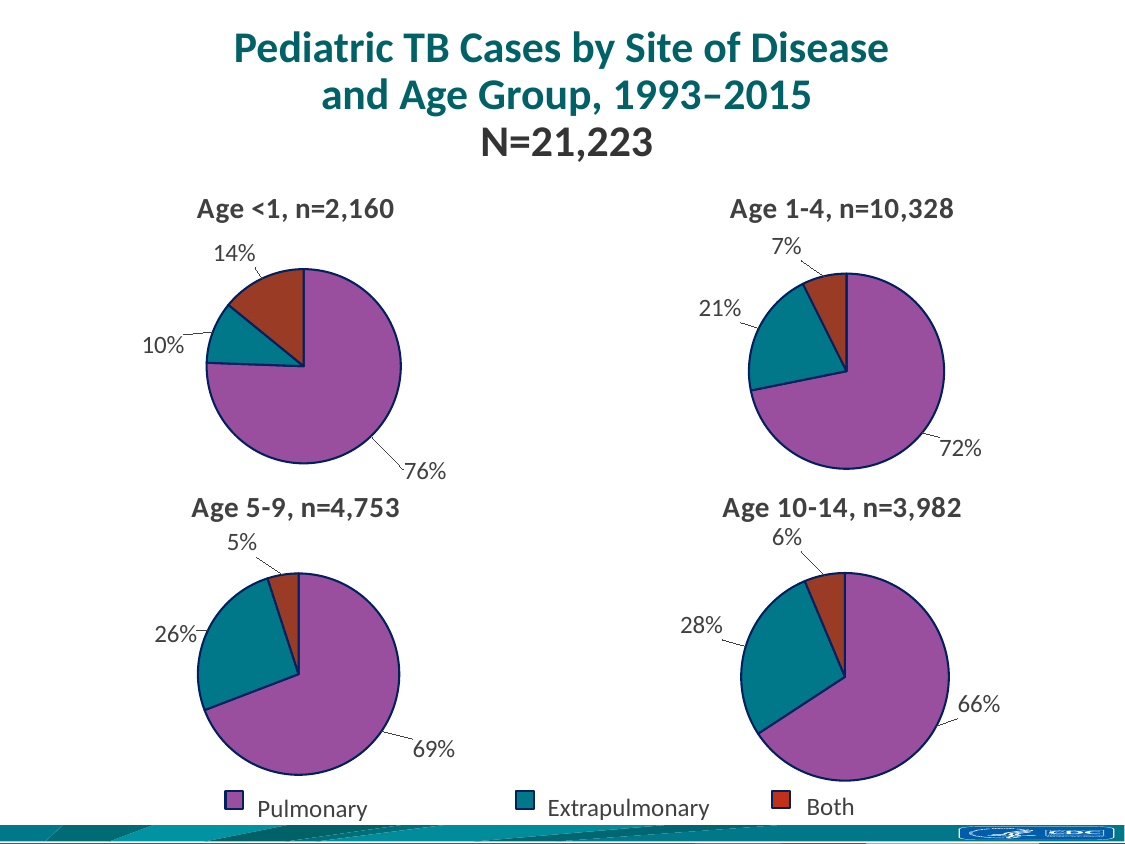
In the 'Age 5-9, n=4,753' pie chart, what share of cases is Both? 5% Which colour represents Extrapulmonary in the legend? Teal How many categories does the legend list? 3 In the 'Age 10-14, n=3,982' pie chart, what share of cases is Pulmonary? 66% How many pie charts are shown on the slide? 4 In the 'Age 1-4, n=10,328' pie chart, what share of cases is Extrapulmonary? 21% In the 'Age <1, n=2,160' pie chart, which is larger: the Both slice or the Extrapulmonary slice? Both In the 'Age 10-14, n=3,982' pie chart, which category has the largest slice? Pulmonary What type of chart is used for the 'Age 5-9, n=4,753' data? Pie chart In the 'Age 1-4, n=10,328' pie chart, what is the difference between the Pulmonary and Extrapulmonary shares? 51% In the 'Age <1, n=2,160' pie chart, which category has the smallest slice? Extrapulmonary